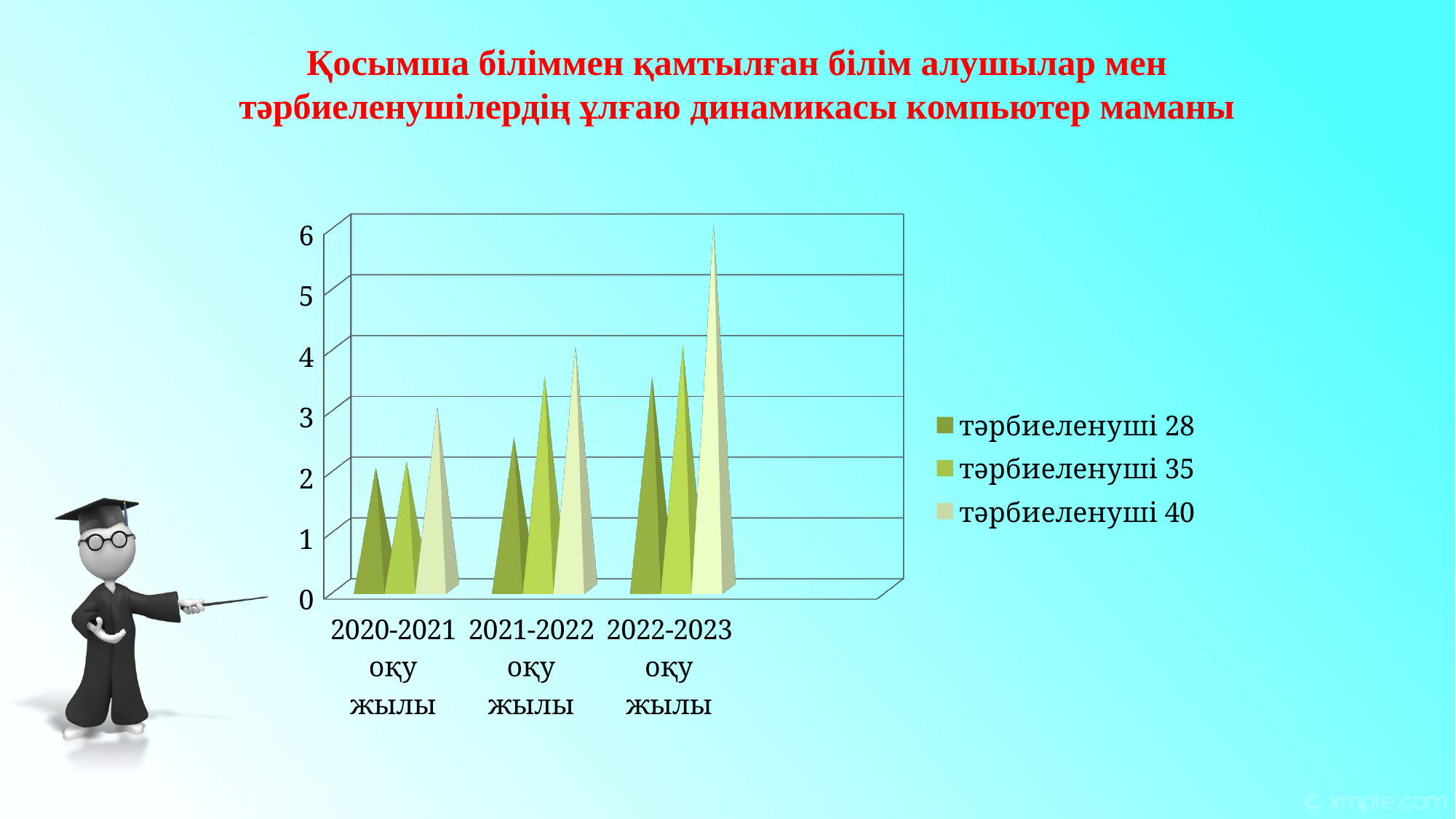
What kind of chart is shown on the slide? bar chart Is the value for тәрбиеленуші 40 in 2022-2023 оқу жылы greater or less than 5? greater Do the values for тәрбиеленуші 40 rise or fall from 2020-2021 to 2022-2023? rise Is the value for тәрбиеленуші 40 in 2021-2022 оқу жылы greater or less than 3? greater Which series has the tallest bar in the 2022-2023 оқу жылы category? тәрбиеленуші 40 How many series does the legend list? 3 Is the value for тәрбиеленуші 28 in 2022-2023 оқу жылы greater or less than 4? less Which is larger: тәрбиеленуші 40 in 2022-2023 оқу жылы or тәрбиеленуші 28 in 2020-2021 оқу жылы? тәрбиеленуші 40 in 2022-2023 оқу жылы Which series has the shortest bar in the 2022-2023 оқу жылы category? тәрбиеленуші 28 Which category has the highest bar in the chart? 2022-2023 оқу жылы How many categories are shown on the x axis? 3